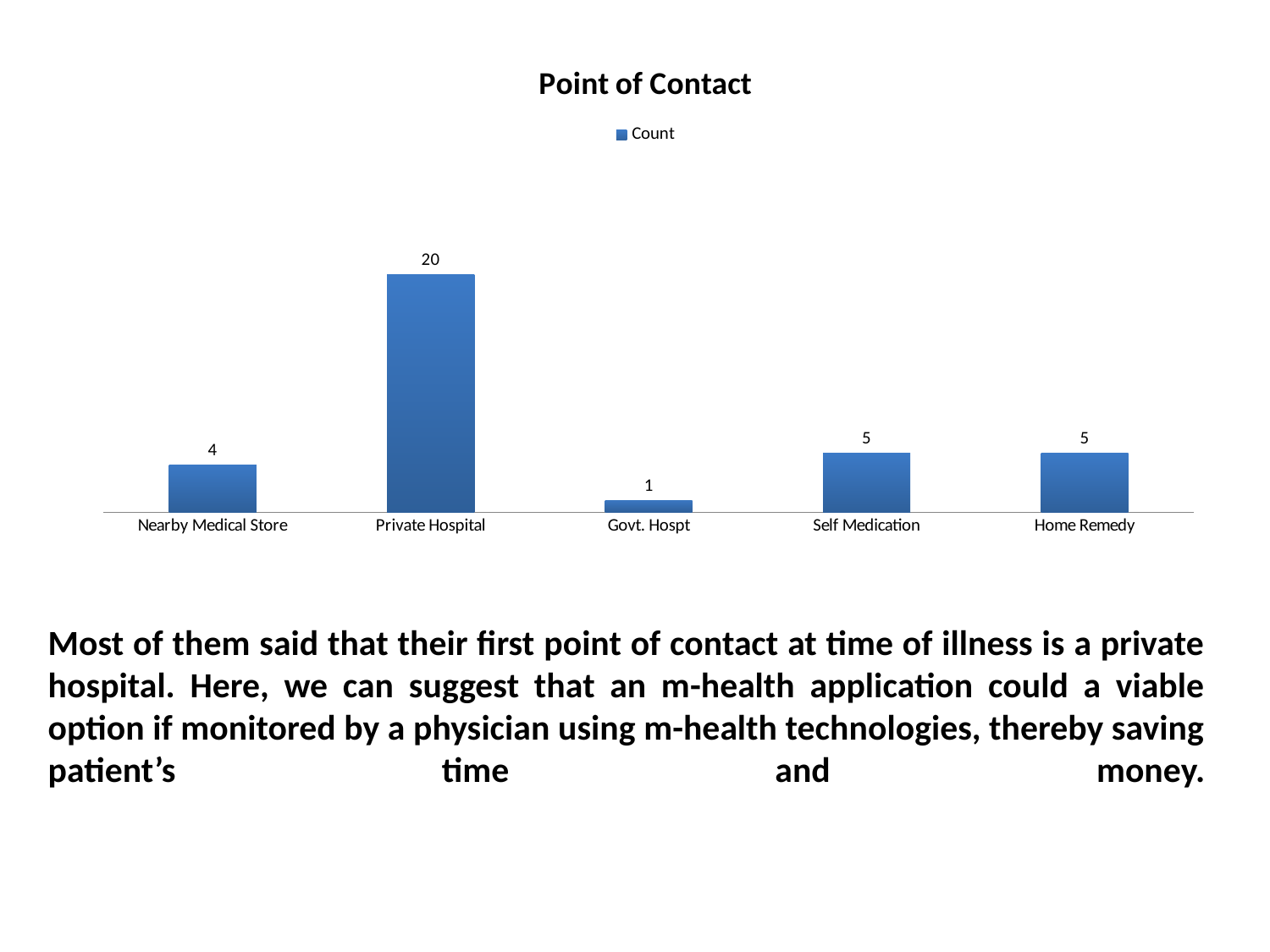
What is the difference between the Count for Private Hospital and the Count for Self Medication? 15 Which has a larger Count, Nearby Medical Store or Home Remedy? Home Remedy What is the Count for Private Hospital? 20 What is the difference between the Count for Nearby Medical Store and the Count for Govt. Hospt? 3 How many categories are shown on the x axis? 5 What is the Count for Nearby Medical Store? 4 What kind of chart is shown? Bar chart What is the Count for Govt. Hospt? 1 Which category has the highest Count? Private Hospital What is the title of the chart? Point of Contact Which category has the lowest Count? Govt. Hospt How many series does the legend list? 1